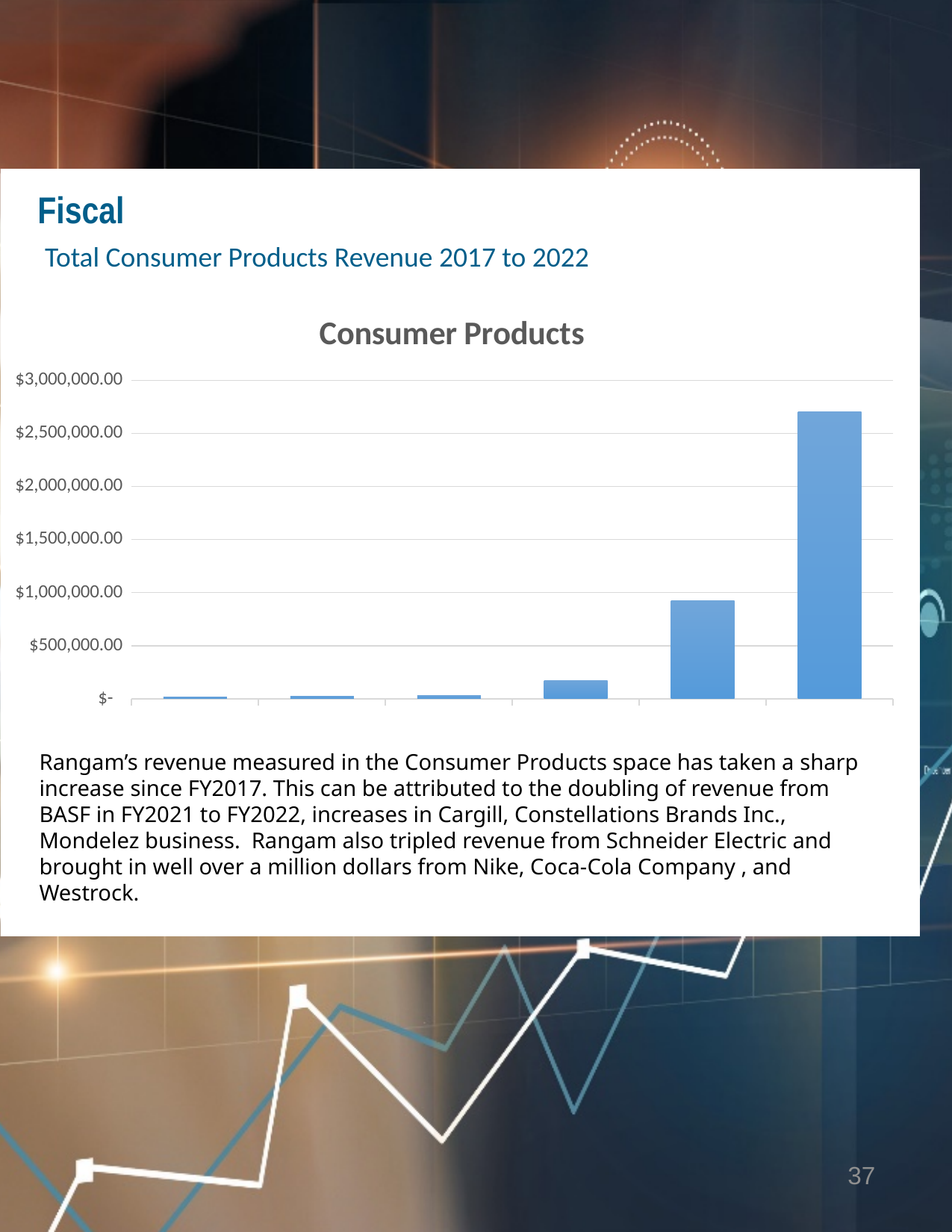
Which is larger, the fourth bar or the fifth bar from the left? the fifth bar Is the value of the fifth bar from the left greater or less than $1,000,000.00? less Which is larger, the fifth bar or the sixth bar from the left? the sixth bar What is the title of the chart? Consumer Products Do the values in the Consumer Products chart generally rise or fall from left to right? rise Is the value of the fourth bar from the left greater or less than $500,000.00? less What kind of chart is shown on the slide? bar chart How many bars are plotted in the Consumer Products chart? 6 Which bar in the Consumer Products chart is the highest? the rightmost (sixth) bar Is the value of the rightmost bar greater or less than $2,500,000.00? greater What is the highest value shown on the vertical axis of the chart? $3,000,000.00